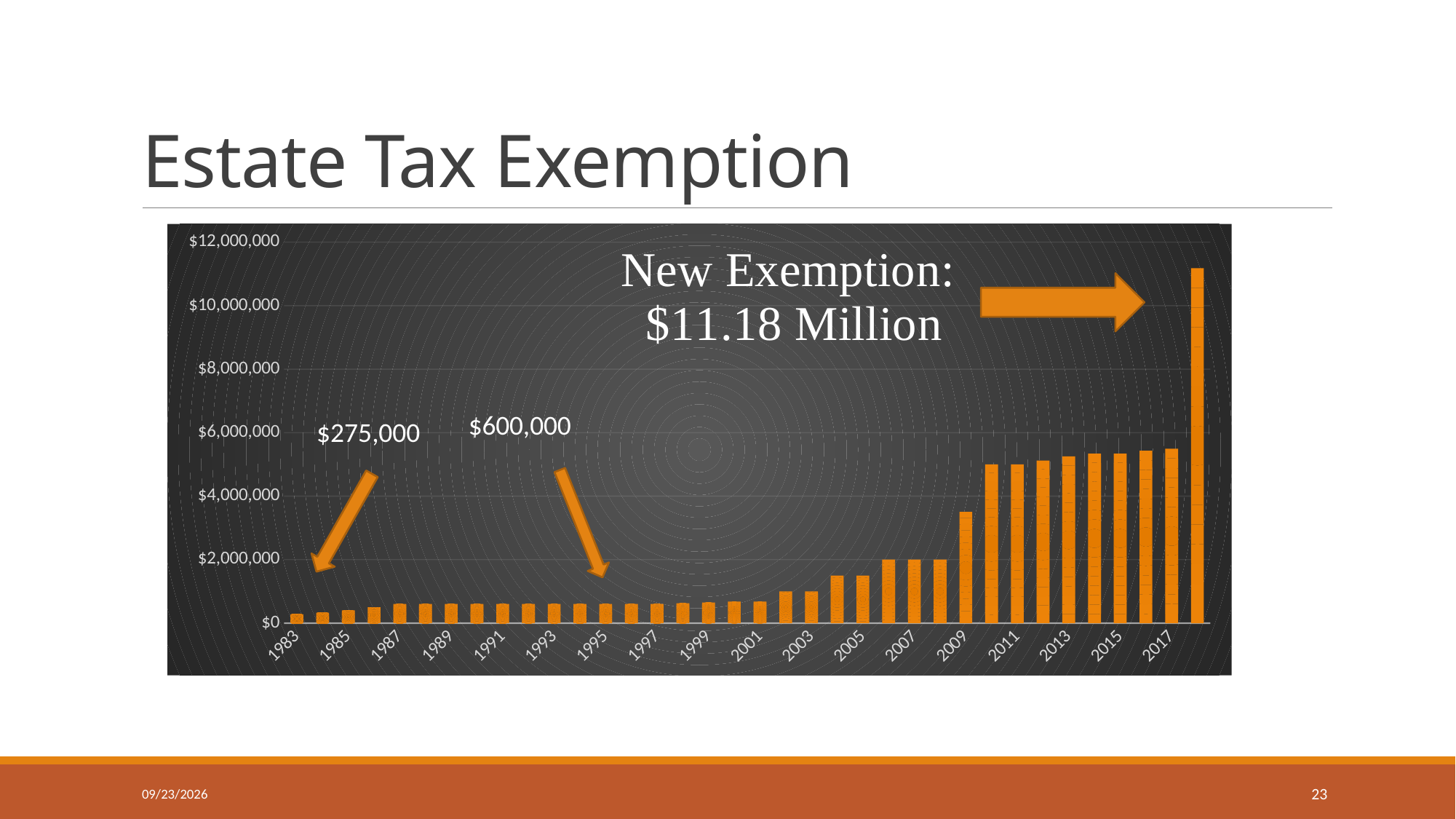
What is the highest value shown on the y axis? $12,000,000 According to the annotation, what is the value of the exemption for 1995? $600,000 Is the value for 2003 greater or less than $2,000,000? less Which year has the larger exemption value, 2001 or 2011? 2011 Which year has the lowest exemption value in the chart? 1983 What is the title of the slide containing the chart? Estate Tax Exemption Is the value for 2017 greater or less than $6,000,000? less According to the annotation, what is the new exemption shown by the tallest bar? $11.18 Million According to the annotation, what is the value of the exemption for 1983? $275,000 Do the exemption values generally rise or fall from 1983 to 2017? rise What kind of chart is shown on the slide? bar chart Is the value for 2009 greater or less than $2,000,000? greater